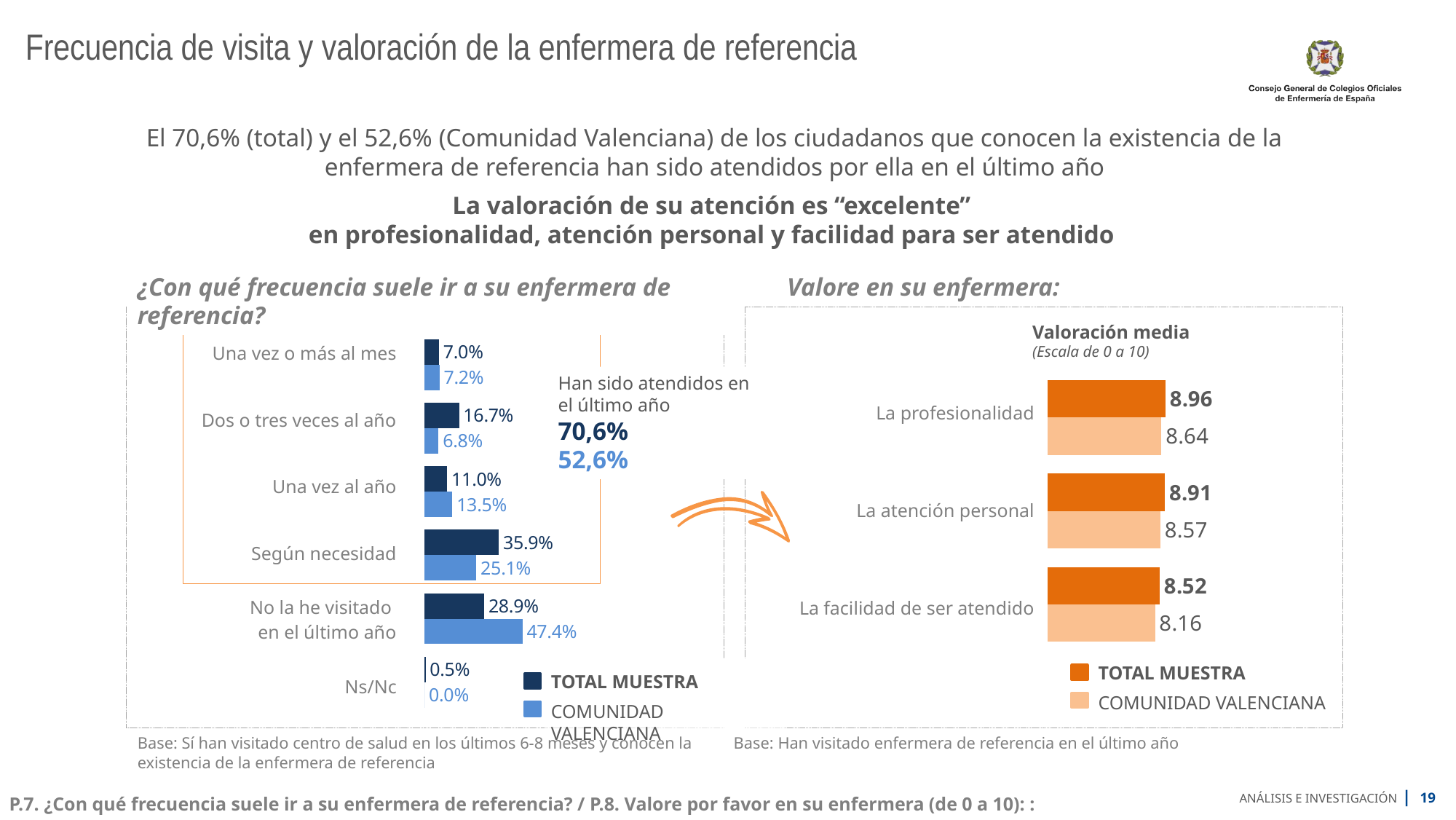
In the right chart 'Valore en su enfermera', what is the difference between the TOTAL MUESTRA and COMUNIDAD VALENCIANA scores for 'La profesionalidad'? 0.32 In the right chart 'Valore en su enfermera', what is the COMUNIDAD VALENCIANA score for 'La facilidad de ser atendido'? 8.16 What type of chart is the right chart 'Valore en su enfermera'? Bar chart In the left chart on visit frequency, which is larger for 'Una vez al año': TOTAL MUESTRA or COMUNIDAD VALENCIANA? COMUNIDAD VALENCIANA In the right chart 'Valore en su enfermera', what is the TOTAL MUESTRA score for 'La atención personal'? 8.91 In the left chart on visit frequency, which category has the lowest TOTAL MUESTRA value? Ns/Nc In the left chart on visit frequency, which category has the highest COMUNIDAD VALENCIANA value? No la he visitado en el último año In the right chart 'Valore en su enfermera', which aspect has the highest TOTAL MUESTRA score? La profesionalidad In the left chart on visit frequency, what is the TOTAL MUESTRA value for 'Según necesidad'? 35.9% In the left chart on visit frequency, what is the COMUNIDAD VALENCIANA value for 'No la he visitado en el último año'? 47.4% In the left chart on visit frequency, what is the difference between the TOTAL MUESTRA and COMUNIDAD VALENCIANA values for 'Dos o tres veces al año'? 9.9% How many categories does the left chart on visit frequency show? 6